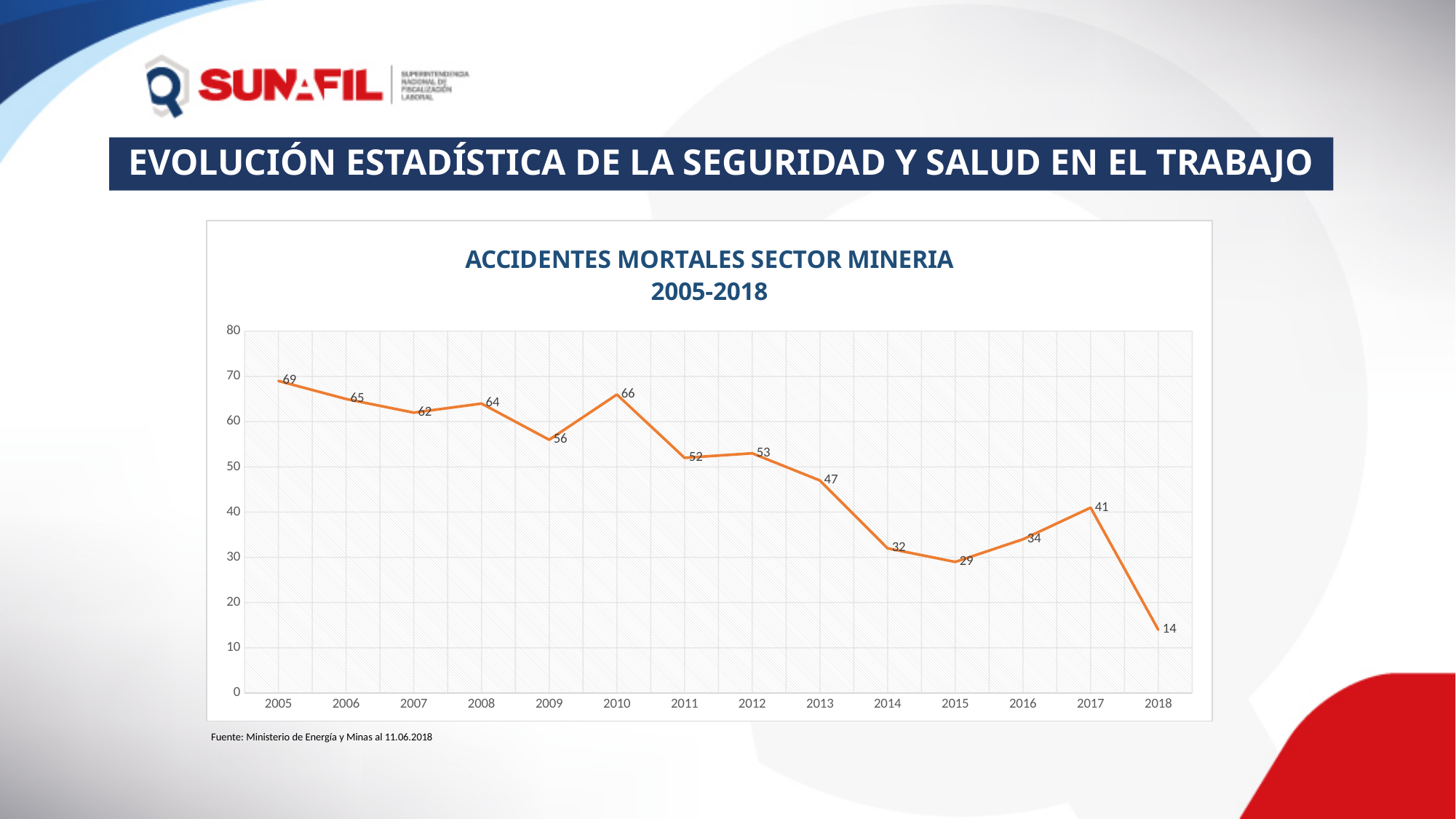
What is the value for 2005? 69 What is the value for 2010? 66 What is the value for 2018? 14 Which is larger, the value for 2011 or the value for 2012? 2012 Which year has the highest value? 2005 What is the title of the chart? ACCIDENTES MORTALES SECTOR MINERIA 2005-2018 Do the values generally rise or fall from 2005 to 2018? fall How many years are plotted on the chart? 14 Which year has the lowest value? 2018 What is the difference between the values for 2017 and 2018? 27 Is the value for 2013 greater or less than 50? less What kind of chart is shown? line chart